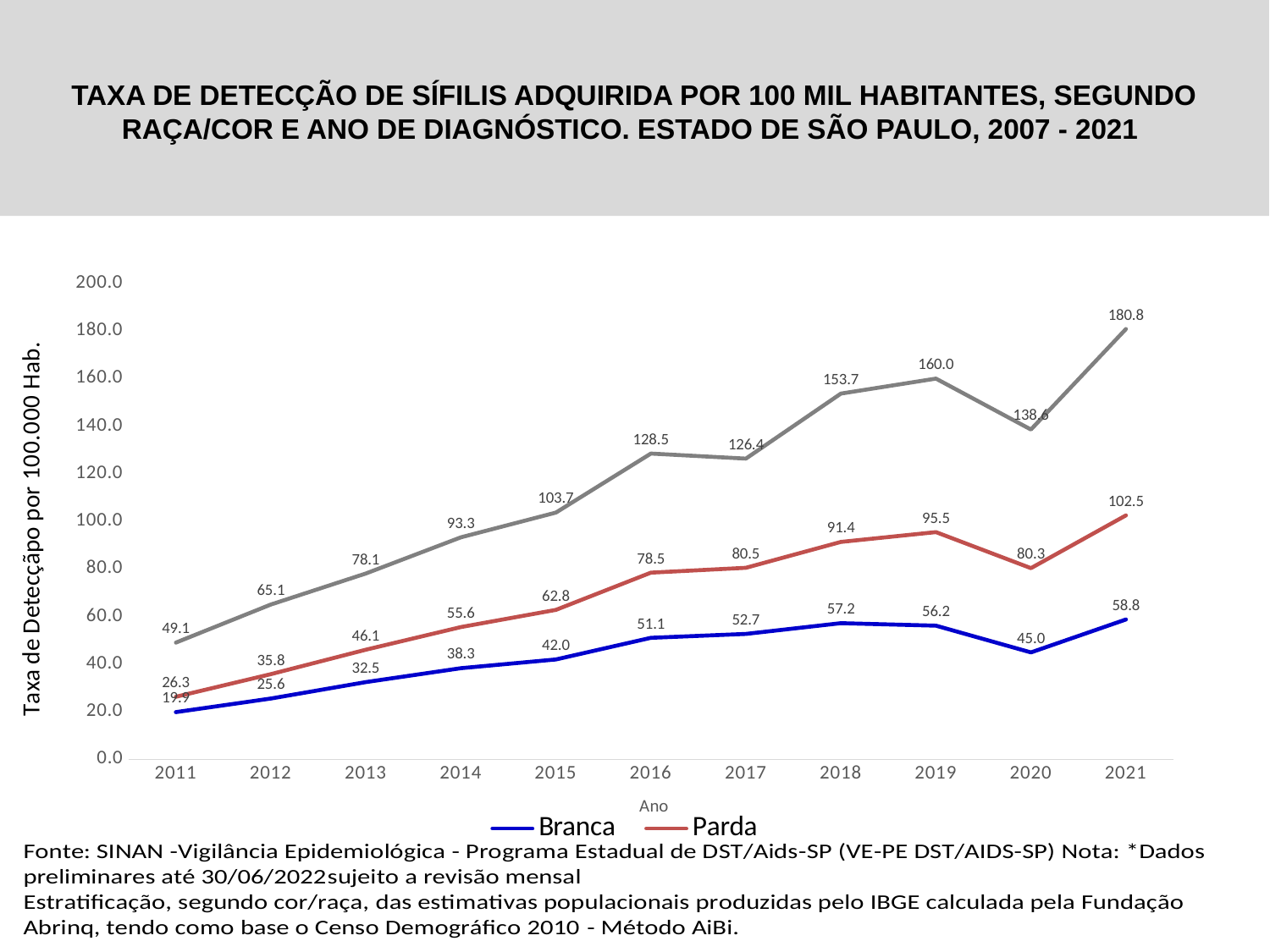
In which year does the Parda series reach its highest value? 2021 Is the value for Parda in 2018 greater or less than 80.0? greater What kind of chart is shown on the slide? line chart What is the value for Parda in 2020? 80.3 Does the Branca series rise or fall from 2011 to 2018? rise What is the value for Parda in 2019? 95.5 What is the difference between the Parda and Branca values in 2021? 43.7 Which year has the higher Branca value, 2019 or 2020? 2019 How many series does the legend list? 2 What is the value for Branca in 2021? 58.8 How many years are shown on the x axis? 11 In which year is the Branca series at its lowest value? 2011